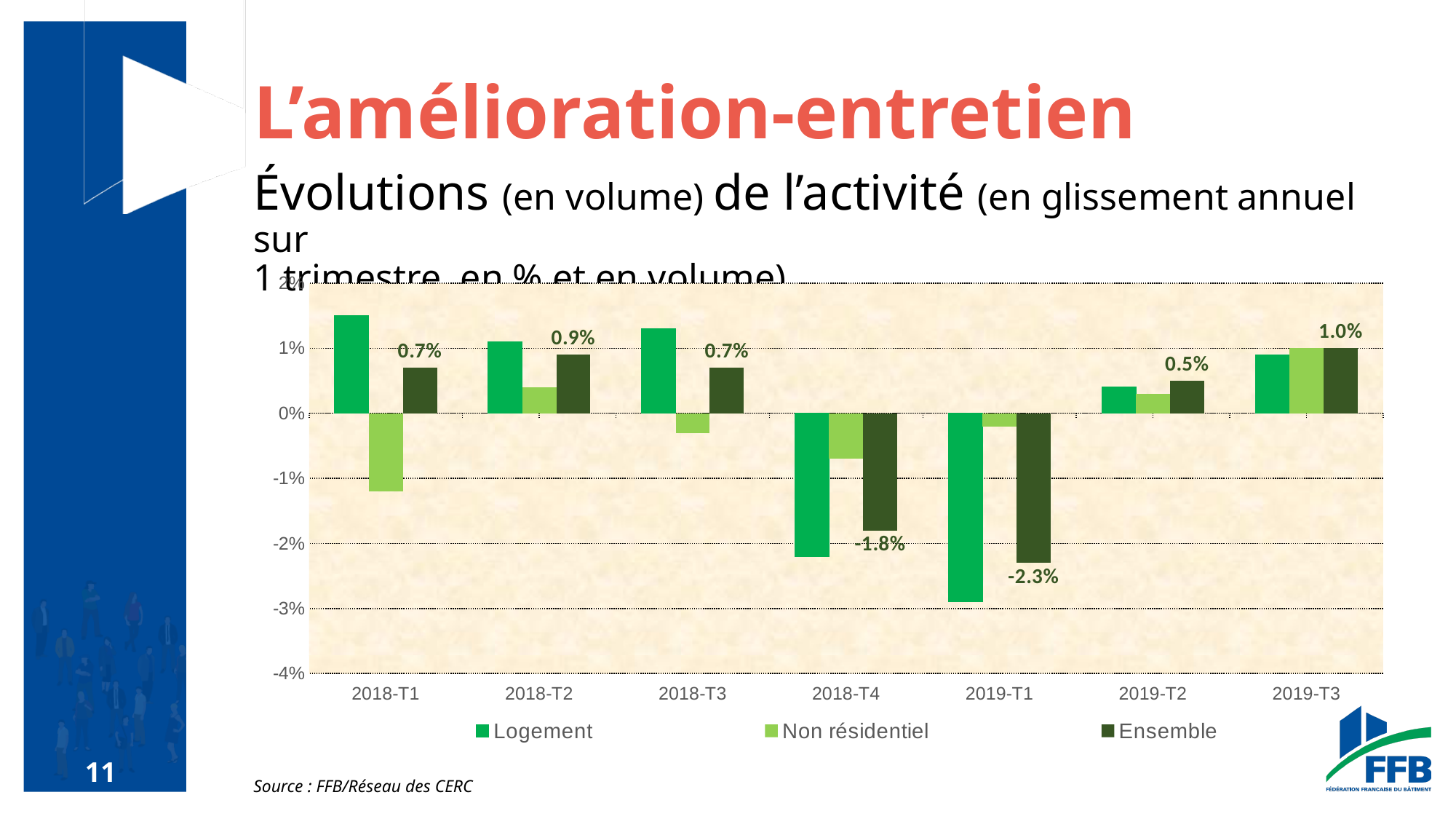
How many quarters are shown on the x axis? 7 What is the difference between the Ensemble values for 2019-T3 and 2019-T2? 0.5 percentage points Which is larger, the Ensemble value for 2018-T1 or for 2018-T2? 2018-T2 In which quarter is the Ensemble value the highest? 2019-T3 What is the value for Ensemble in 2018-T2? 0.9% Is the value for Logement in 2018-T1 greater or less than 1%? greater In which quarter is the Ensemble value the lowest? 2019-T1 How many series does the legend list? 3 What is the value for Ensemble in 2019-T1? -2.3% What is the value for Ensemble in 2018-T4? -1.8% What kind of chart is shown on the slide? bar chart Is the value for Logement in 2019-T1 greater or less than -2%? less